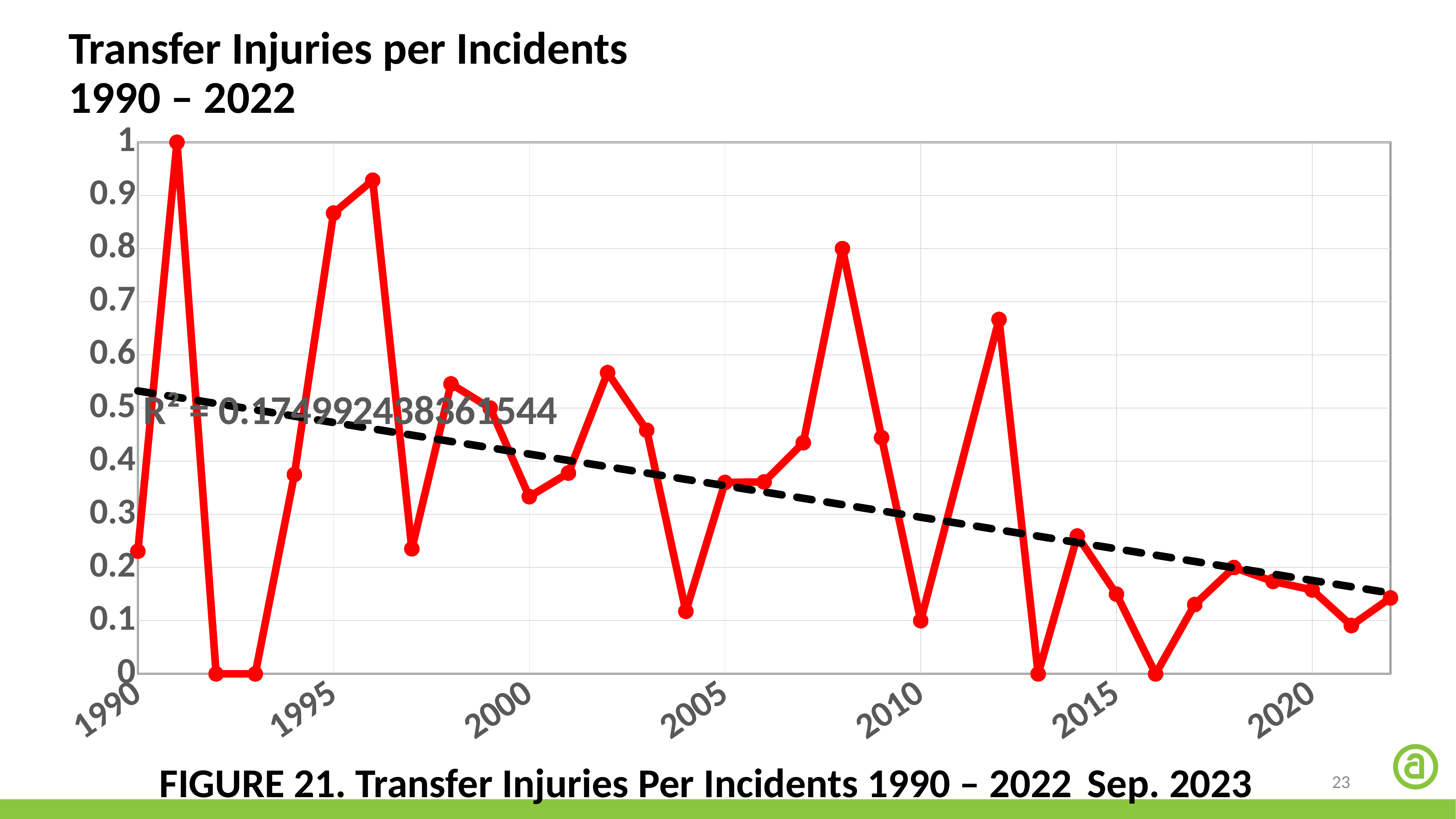
What is the lowest value plotted on the chart? 0 Is the value for 2022 greater or less than 0.2? less Which year has the highest value of transfer injuries per incidents? 1991 What kind of chart is shown on the slide? line chart What is the title of the chart? Transfer Injuries per Incidents 1990 – 2022 What R² value is printed on the chart? 0.174992438361544 What is the value for 1992? 0 Is the value for 2008 greater or less than 0.7? greater According to the dashed trendline, do the values generally rise or fall from 1990 to 2022? fall What is the value for 1991? 1 Is the value for 1990 greater or less than 0.3? less Which is larger, the value for 1996 or the value for 2008? 1996